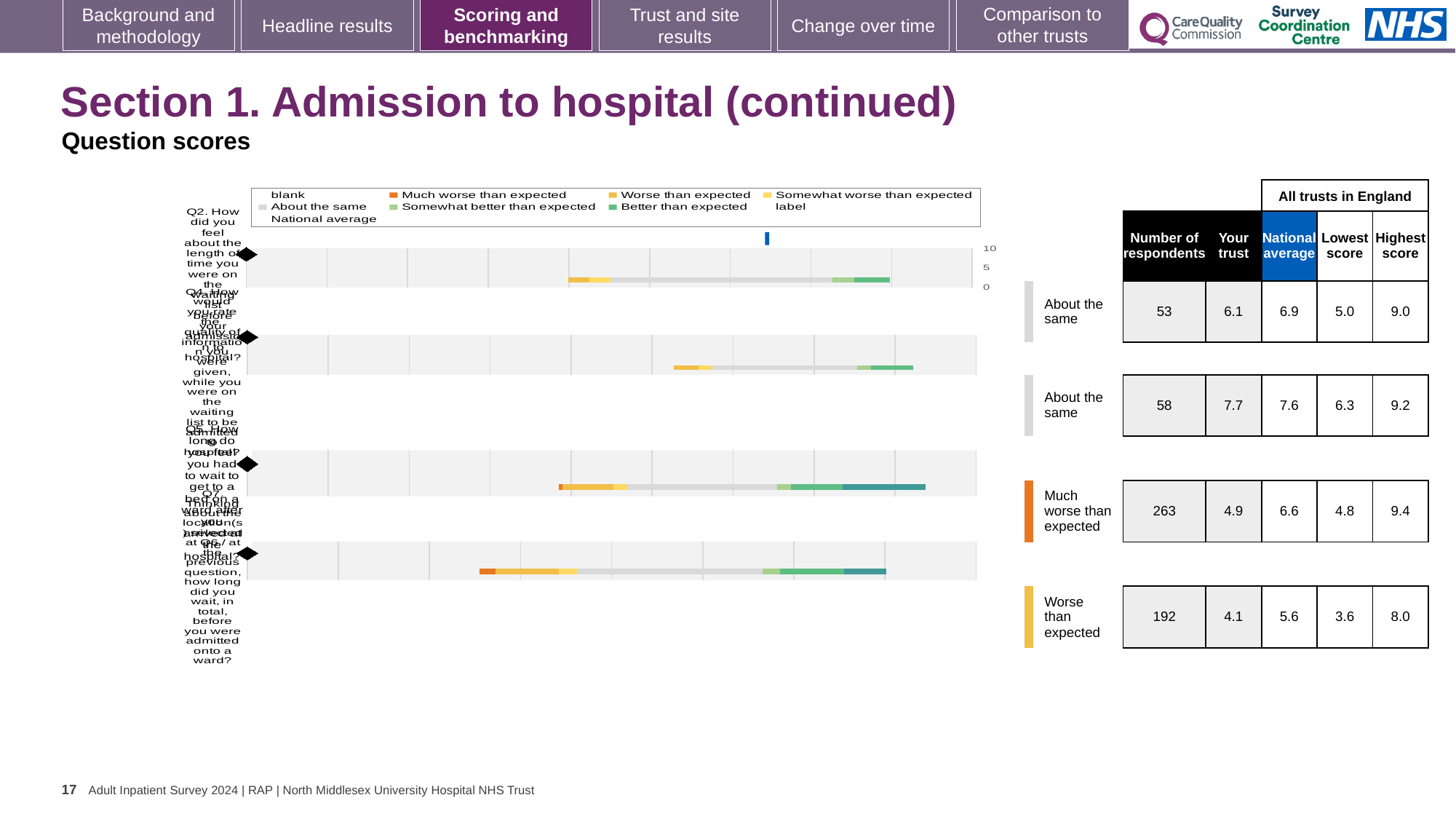
What kind of chart is shown on the left of the slide? bar chart In the table beside the chart, which row has the largest number of respondents? the third row (Much worse than expected), 263 In the table beside the chart, what is the 'Your trust' score for the first row? 6.1 For the second row of the table, which is larger: the 'Your trust' score or the national average? Your trust (7.7) In the table beside the chart, which row has the lowest 'Your trust' score? the fourth row (Worse than expected), 4.1 In the table beside the chart, what is the national average for the second row? 7.6 How many horizontal bars (questions) are plotted in the chart? 4 For the third row of the table (rated 'Much worse than expected'), what is the difference between the national average and the 'Your trust' score? 1.7 In the table beside the chart, how many respondents are listed for the third row (rated 'Much worse than expected')? 263 What benchmark rating is shown for the first row of the table? About the same In the table beside the chart, what is the highest score for the fourth row (rated 'Worse than expected')? 8.0 What is the heading above the 'National average', 'Lowest score' and 'Highest score' columns in the table? All trusts in England